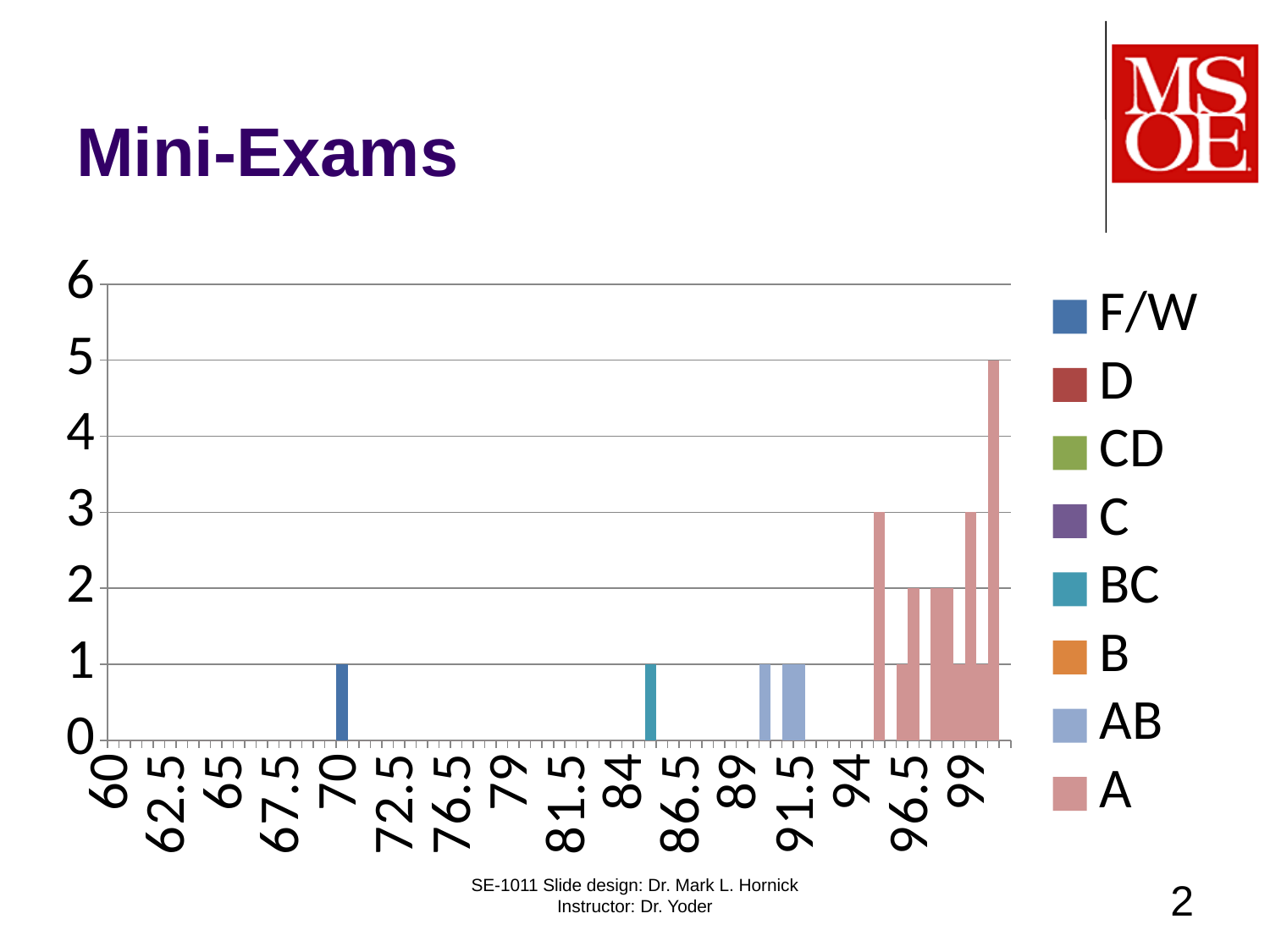
How many series does the legend list? 8 How many bars belong to the F/W series? 1 Which is larger: the tallest A bar or the F/W bar at 70? the tallest A bar What is the value of the F/W bar at 70? 1 What kind of chart is shown on the slide? bar chart How many bars belong to the BC series? 1 Is the tallest bar in the chart greater or less than 4? greater What is the height of the tallest bar in the chart? 5 What is the highest value shown on the vertical axis? 6 What is the title of the slide containing the chart? Mini-Exams Which series does the tallest bar in the chart belong to? A Is the F/W bar at 70 greater or less than 2? less